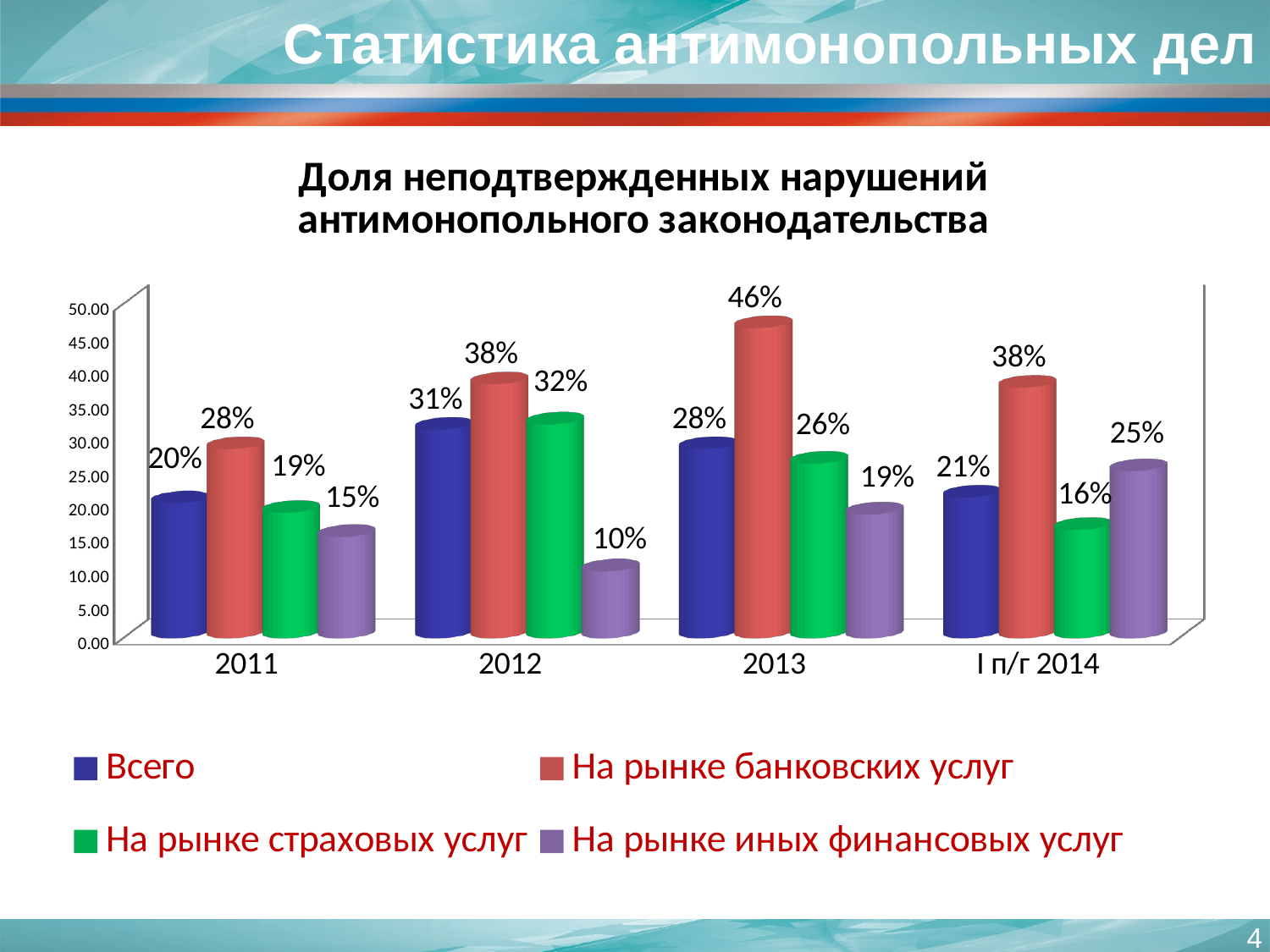
In which category is the value for "На рынке иных финансовых услуг" lowest? 2012 What is the title of the chart? Доля неподтвержденных нарушений антимонопольного законодательства Which is larger in I п/г 2014: "На рынке страховых услуг" or "На рынке иных финансовых услуг"? На рынке иных финансовых услуг How many categories are shown on the x axis? 4 What is the difference between "На рынке банковских услуг" and "Всего" in 2013? 18% In which year does "На рынке банковских услуг" reach its highest value? 2013 What kind of chart is shown on the slide? Bar chart What is the value for "На рынке банковских услуг" in 2013? 46% How many series does the legend list? 4 What is the value for "На рынке иных финансовых услуг" in I п/г 2014? 25% What is the value for "На рынке страховых услуг" in 2011? 19% What is the value for "Всего" in 2012? 31%